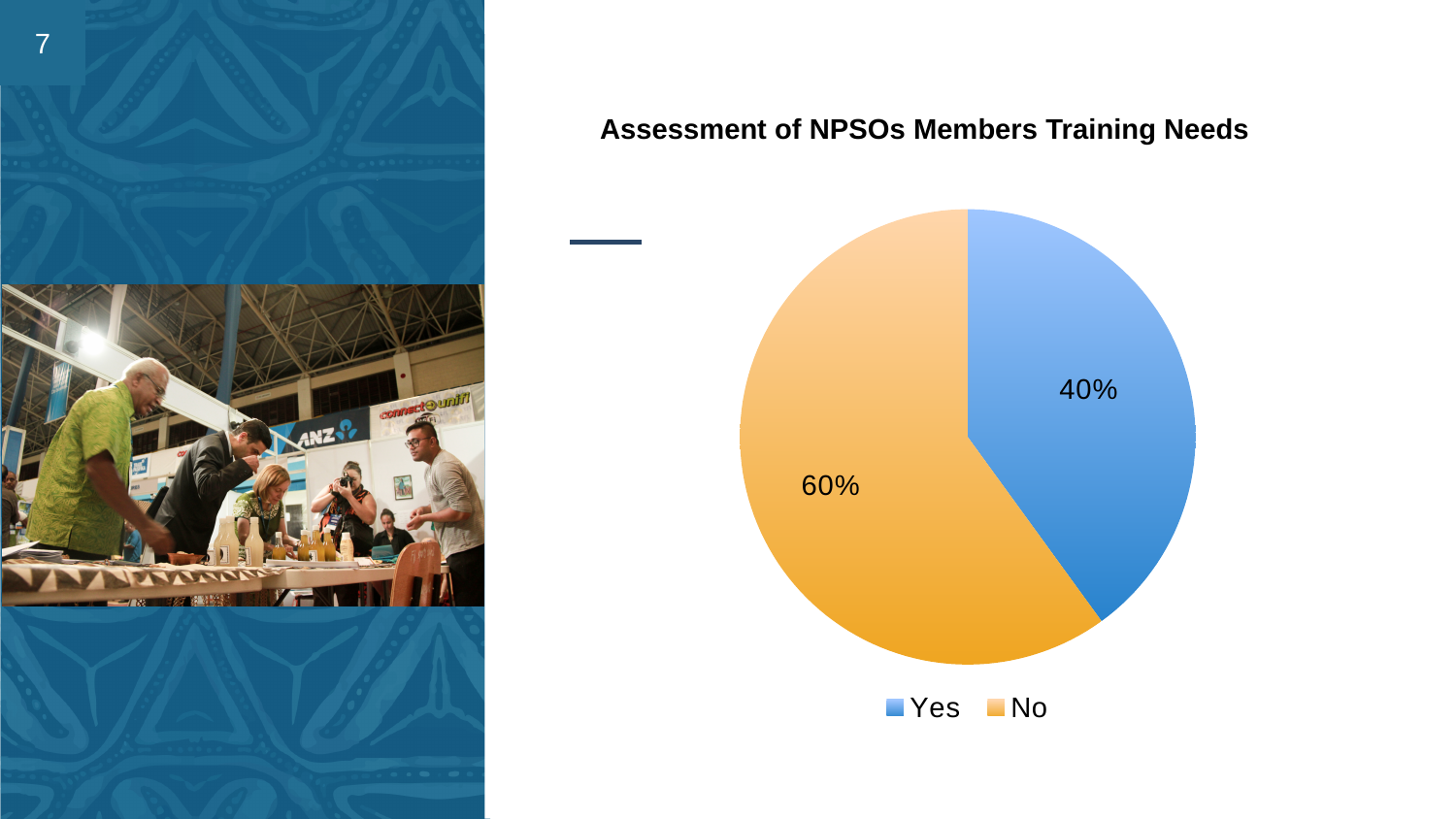
What colour is the "Yes" slice? blue What is the value for the "No" slice? 60% How many slices does the pie chart have? 2 What kind of chart is shown on the slide? pie chart What is the difference between the "No" and "Yes" shares? 20% Which category has the largest share of the pie? No Which is larger, the "Yes" slice or the "No" slice? No Which category has the smallest share of the pie? Yes How many entries does the legend list? 2 What is the title of the chart? Assessment of NPSOs Members Training Needs What is the value for the "Yes" slice? 40% What share of the pie does the "No" slice represent? 60%